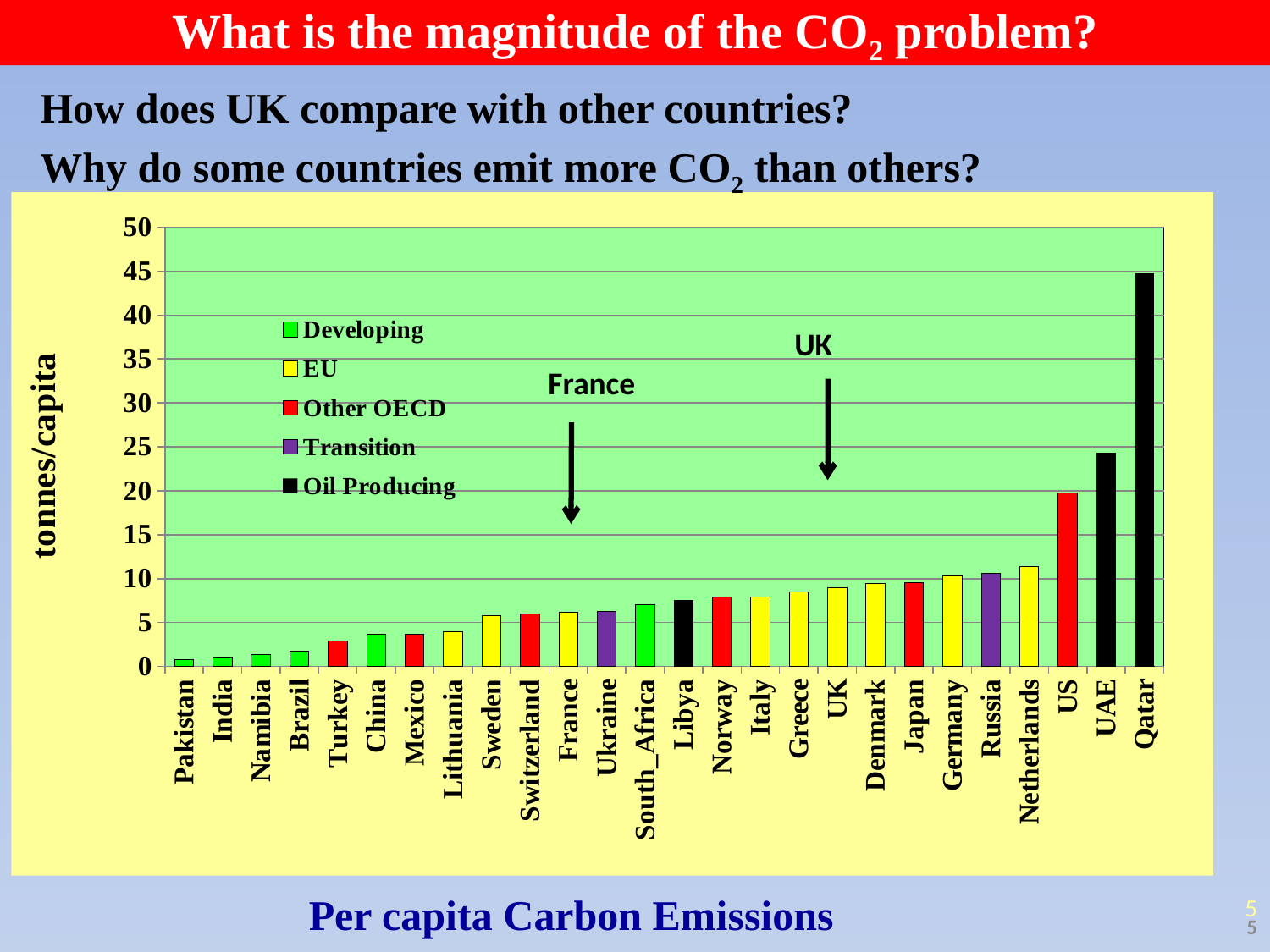
Is the value for UK greater or less than 10 tonnes/capita? less How many categories does the chart's legend list? 5 What kind of chart is shown on the slide? bar chart Which country has the lowest per capita carbon emissions in the chart? Pakistan What colour does the legend use for Oil Producing countries? black Is the value for UAE greater or less than 20 tonnes/capita? greater Which country has the highest per capita carbon emissions in the chart? Qatar How many countries are shown on the x axis of the chart? 26 Do the bar values rise or fall moving from left to right along the x axis? rise Which country has higher per capita emissions, US or UK? US Is the value for Qatar greater or less than 40 tonnes/capita? greater